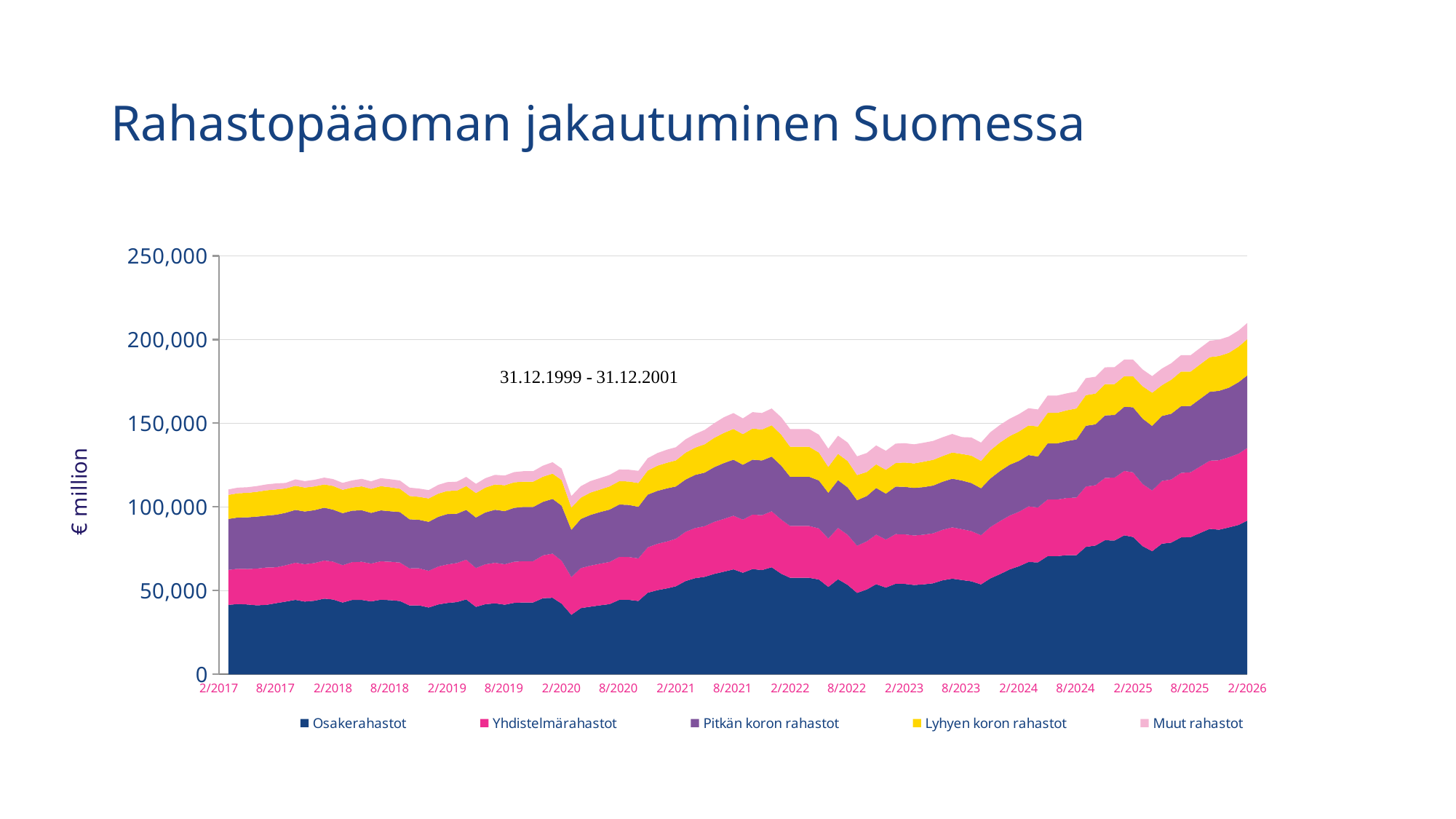
Does the total fund capital rise or fall overall from 2/2017 to 2/2026? rise Is the total fund capital at 2/2026 greater or less than 200,000? greater Which series has the smallest value at 2/2026? Muut rahastot How many date labels are shown on the x axis? 19 Is the value for Osakerahastot at 2/2017 greater or less than 50,000? less What kind of chart is shown on the slide? Stacked area chart Is the total fund capital at 2/2017 greater or less than 150,000? less What is the title of the chart? Rahastopääoman jakautuminen Suomessa What is the label on the vertical axis? € million Which series has the largest value at 2/2026? Osakerahastot How many series does the legend list? 5